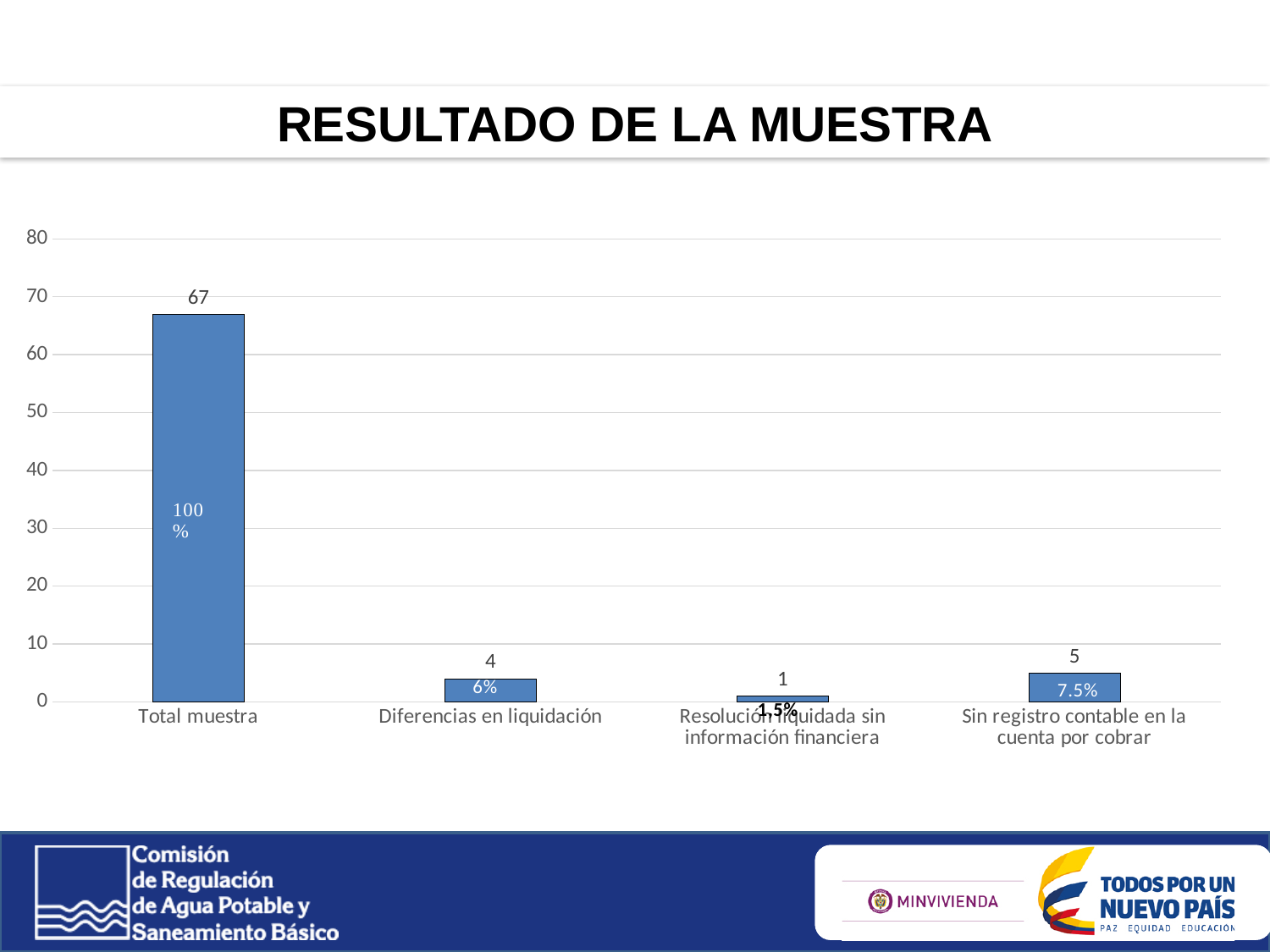
What percentage label is shown inside the bar for Sin registro contable en la cuenta por cobrar? 7.5% What is the value for Total muestra? 67 What is the difference between the values for Total muestra and Sin registro contable en la cuenta por cobrar? 62 What is the value for Resolución liquidada sin información financiera? 1 Which category has the highest value? Total muestra Which is larger, the value for Diferencias en liquidación or the value for Sin registro contable en la cuenta por cobrar? Sin registro contable en la cuenta por cobrar Is the value for Total muestra greater or less than 60? greater Which category has the lowest value? Resolución liquidada sin información financiera How many categories are shown on the x axis? 4 What is the value for Sin registro contable en la cuenta por cobrar? 5 What is the value for Diferencias en liquidación? 4 What kind of chart is shown on the slide? bar chart